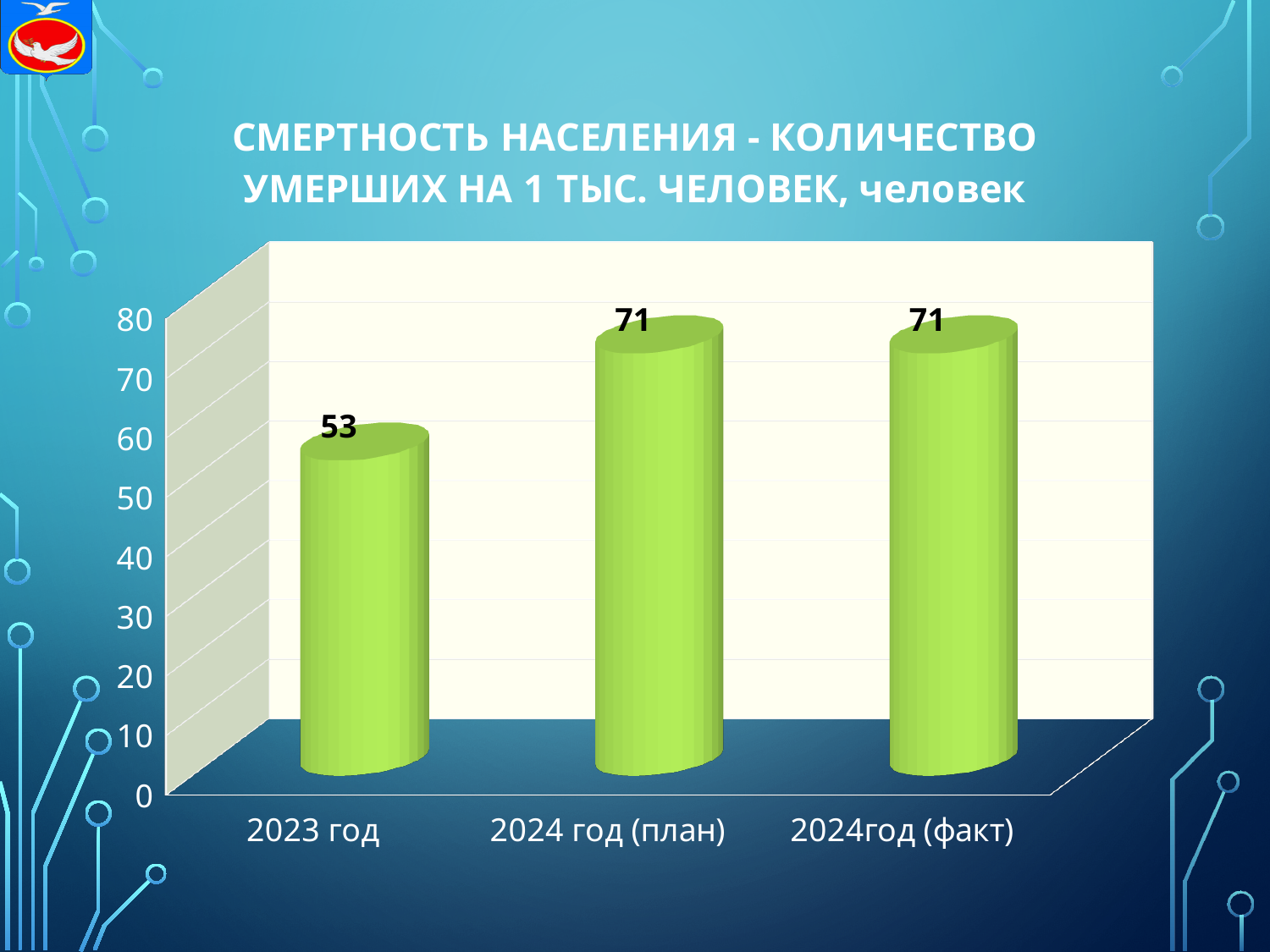
What is the difference between the values for 2024 год (план) and 2023 год? 18 Which is larger, the value for 2023 год or the value for 2024год (факт)? 2024год (факт) What is the value for 2023 год? 53 What is the title of the chart? СМЕРТНОСТЬ НАСЕЛЕНИЯ - КОЛИЧЕСТВО УМЕРШИХ НА 1 ТЫС. ЧЕЛОВЕК, человек Do the values rise or fall from 2023 год to 2024 год (план)? rise How many categories are shown on the x axis? 3 What kind of chart is shown on the slide? bar chart What is the value for 2024год (факт)? 71 What is the value for 2024 год (план)? 71 Is the value for 2023 год greater or less than 60? less Is the value for 2024 год (план) greater or less than 70? greater Which category has the lowest value? 2023 год